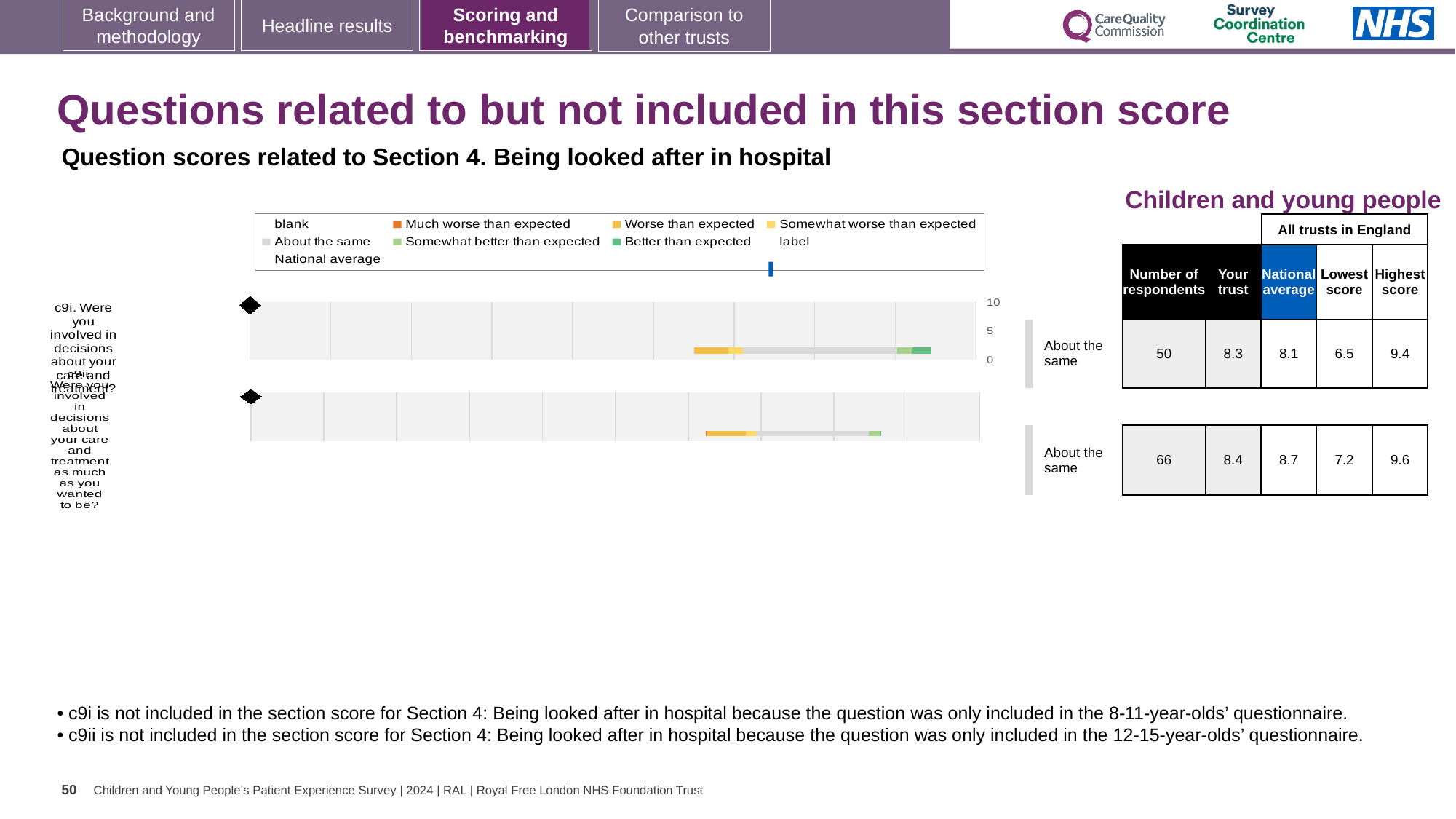
Which question has the higher 'Your trust' score, c9i or c9ii? c9ii How many questions are plotted in the chart? 2 What is the national average score for question c9ii? 8.7 What is the 'Your trust' score for question c9i? 8.3 What benchmark category is shown for question c9i? About the same What is the difference between the highest and lowest scores for question c9i? 2.9 What is the highest score among all trusts in England for question c9ii? 9.6 How many respondents answered question c9i? 50 By how much does the national average exceed the trust's score for question c9ii? 0.3 What is the lowest score among all trusts in England for question c9ii? 7.2 What kind of chart is used to show the question scores for c9i and c9ii? bar chart What is the maximum value shown on the chart's score axis? 10